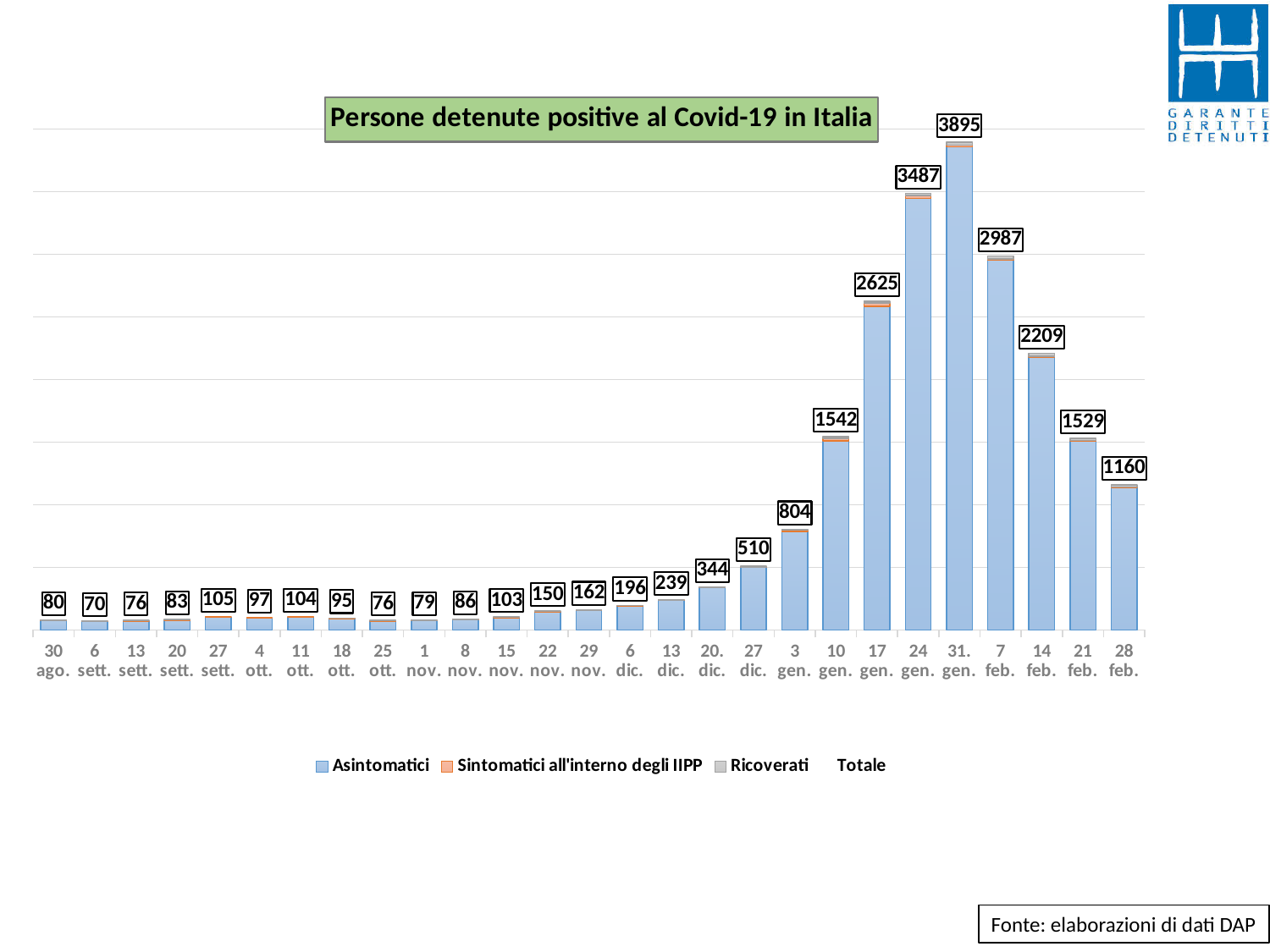
What is the total value shown for 30 ago.? 80 Which date has the lowest total? 6 sett. What is the difference between the totals for 31 gen. and 24 gen.? 408 How many dates are shown on the x axis? 27 What is the total value shown for 31 gen.? 3895 Which has a larger total, 7 feb. or 14 feb.? 7 feb. Which date has the highest total? 31 gen. How many entries does the legend list? 4 What kind of chart is this? Stacked bar chart What is the total value shown for 28 feb.? 1160 What is the title of the chart? Persone detenute positive al Covid-19 in Italia What is the total value shown for 3 gen.? 804